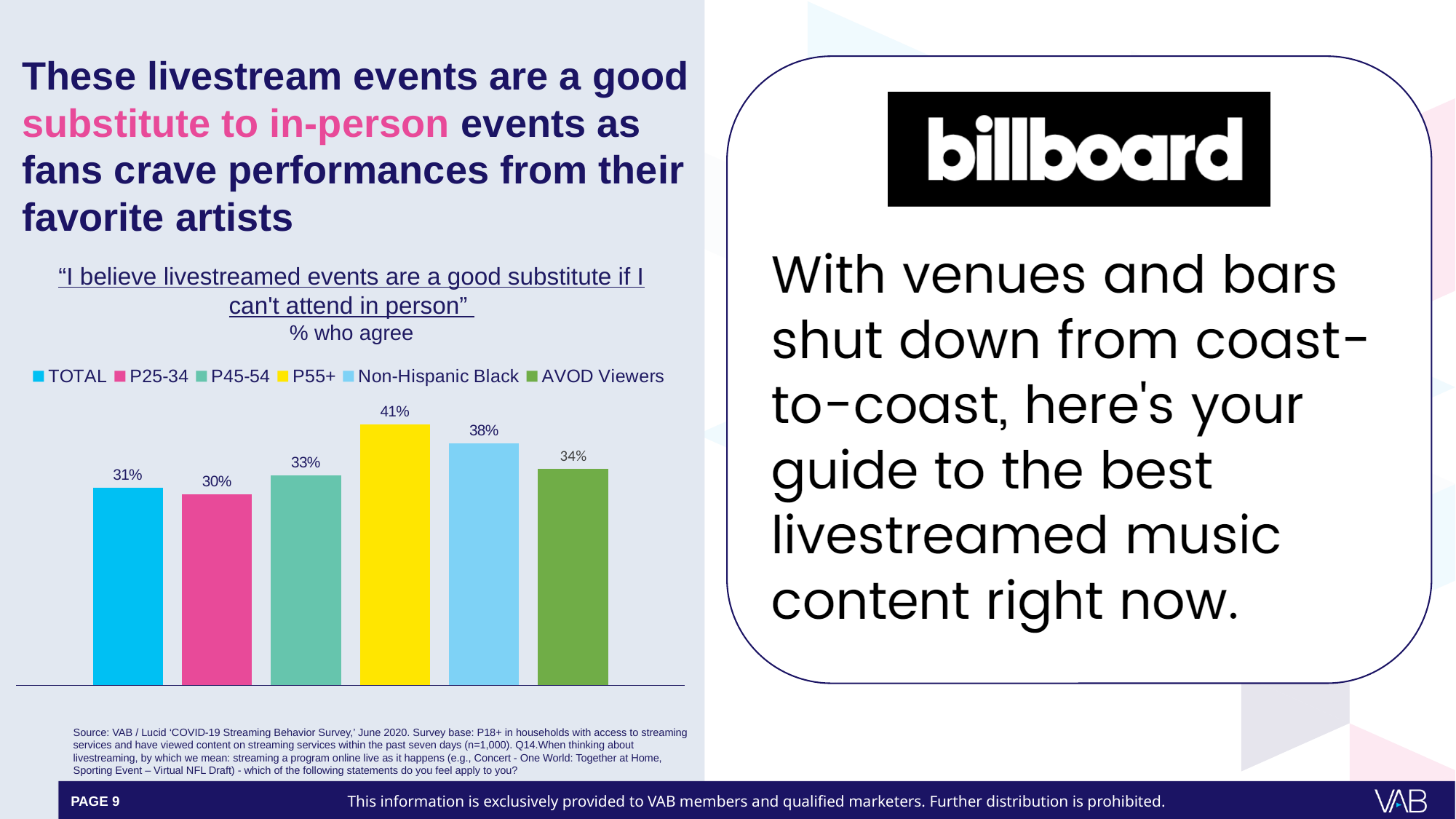
What colour is the bar for P55+? Yellow How many groups are plotted in the chart? 6 Which is larger, the value for P45-54 or the value for AVOD Viewers? AVOD Viewers What is the value shown for Non-Hispanic Black in the chart? 38% Which group has the highest percentage who agree? P55+ What percentage of the TOTAL group agrees that livestreamed events are a good substitute if they can't attend in person? 31% What is the difference in percentage points between Non-Hispanic Black and TOTAL? 7 What is the difference in percentage points between P55+ and P25-34? 11 Which group has the lowest percentage who agree? P25-34 What kind of chart is shown on the slide? Bar chart What is the value shown for AVOD Viewers in the chart? 34% What is the value shown for P55+ in the chart? 41%